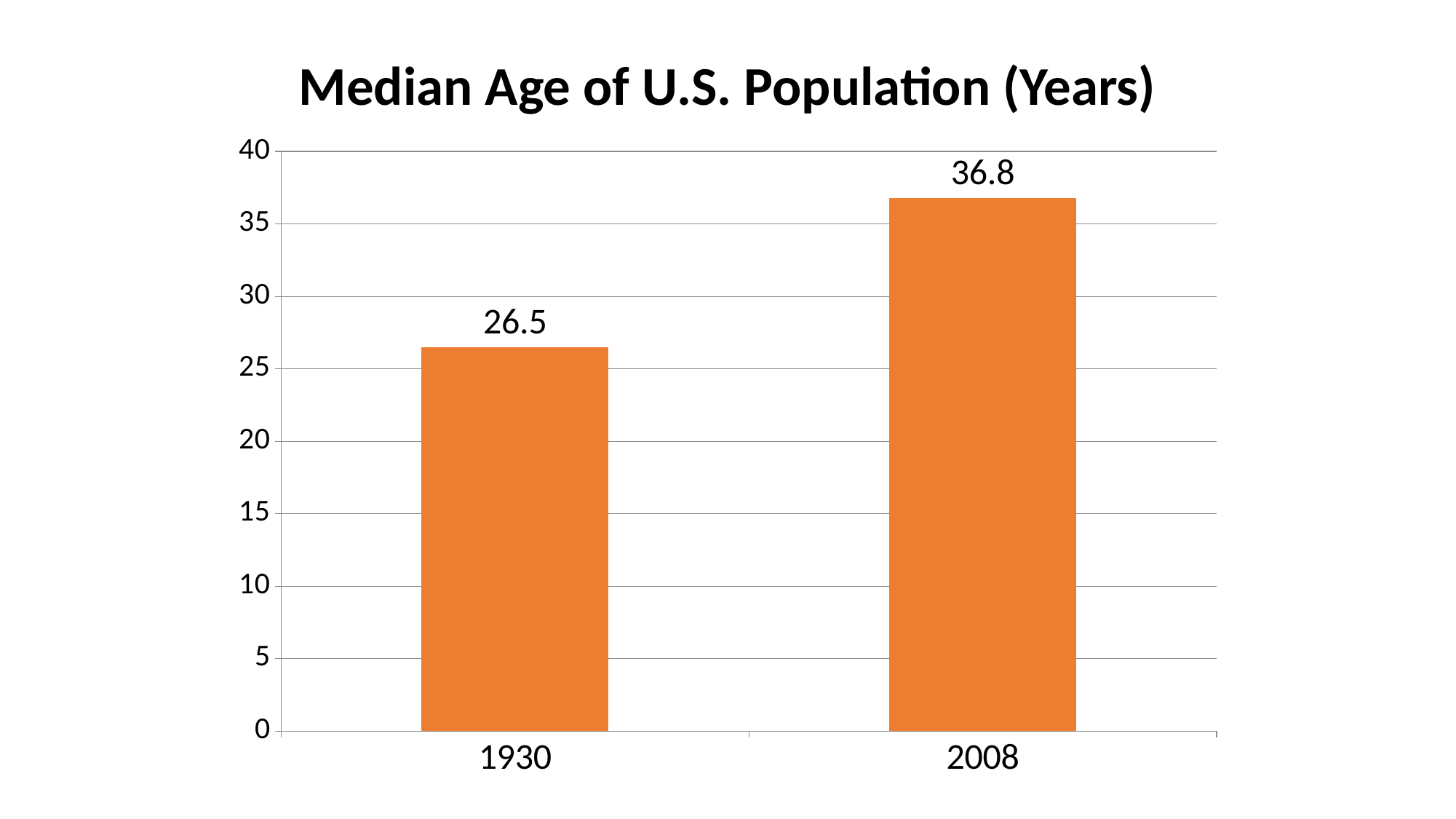
How many years are shown on the x axis of the chart? 2 Does the median age rise or fall from 1930 to 2008? Rise By how many years did the median age increase from 1930 to 2008? 10.3 Which year has the higher median age? 2008 What is the median age of the U.S. population shown for 2008? 36.8 Is the median age for 2008 greater or less than 35? greater What is the maximum value shown on the vertical axis? 40 Which year has the lower median age? 1930 What is the title of the chart? Median Age of U.S. Population (Years) What kind of chart is shown on the slide? Bar chart Is the median age for 1930 greater or less than 30? less What is the median age of the U.S. population shown for 1930? 26.5